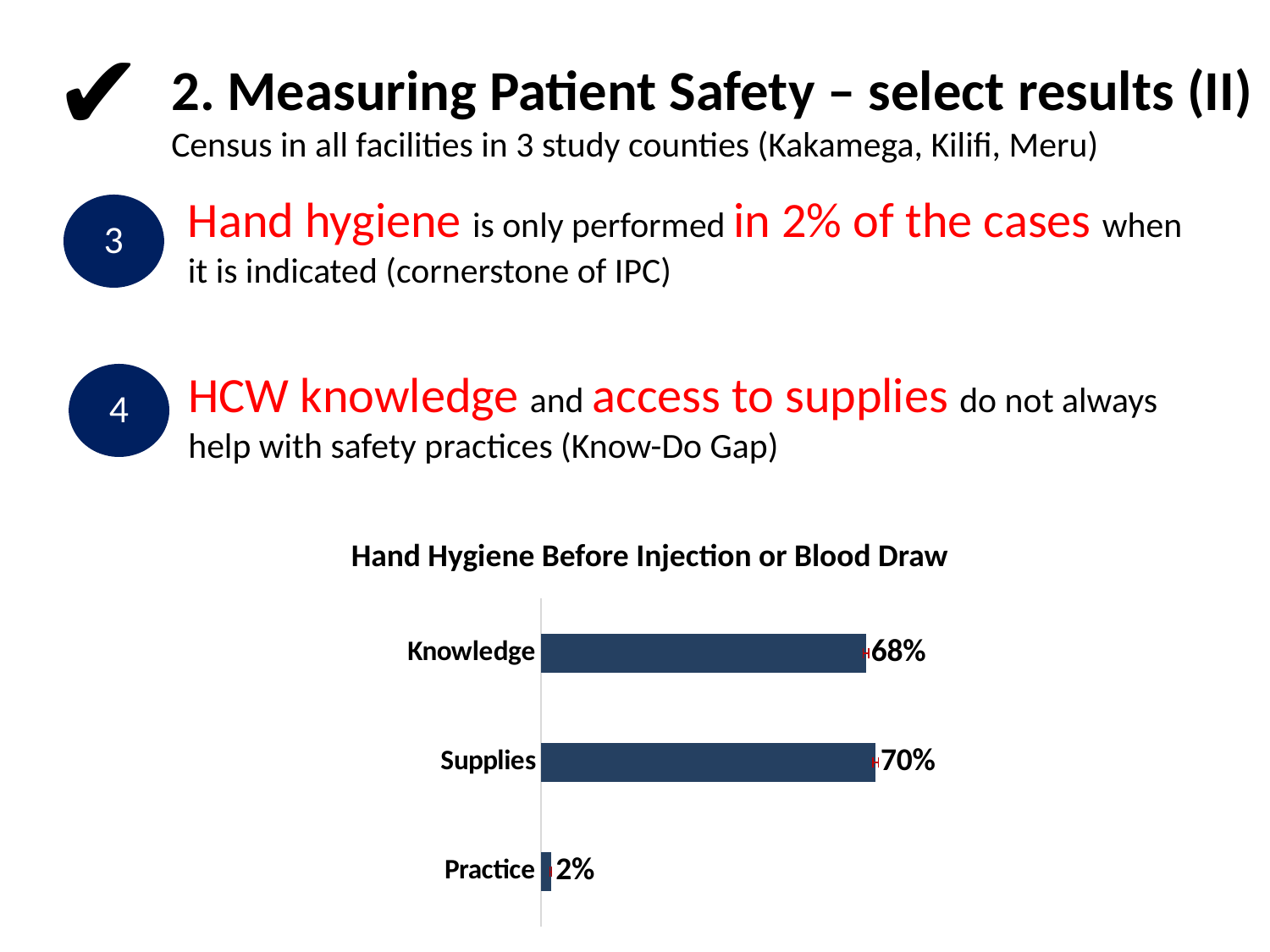
What is the value for Supplies in the chart? 70% What is the value for Practice in the chart? 2% What is the value for Knowledge in the Hand Hygiene Before Injection or Blood Draw chart? 68% What kind of chart is shown on the slide? Bar chart Which category has the lowest value in the chart? Practice How many categories are shown in the chart? 3 Which category has the highest value in the chart? Supplies What is the title of the chart on the slide? Hand Hygiene Before Injection or Blood Draw Which category is listed at the bottom of the chart? Practice What is the difference between the values for Knowledge and Practice? 66% What is the difference between the values for Supplies and Knowledge? 2% Which is larger, the value for Knowledge or the value for Practice? Knowledge